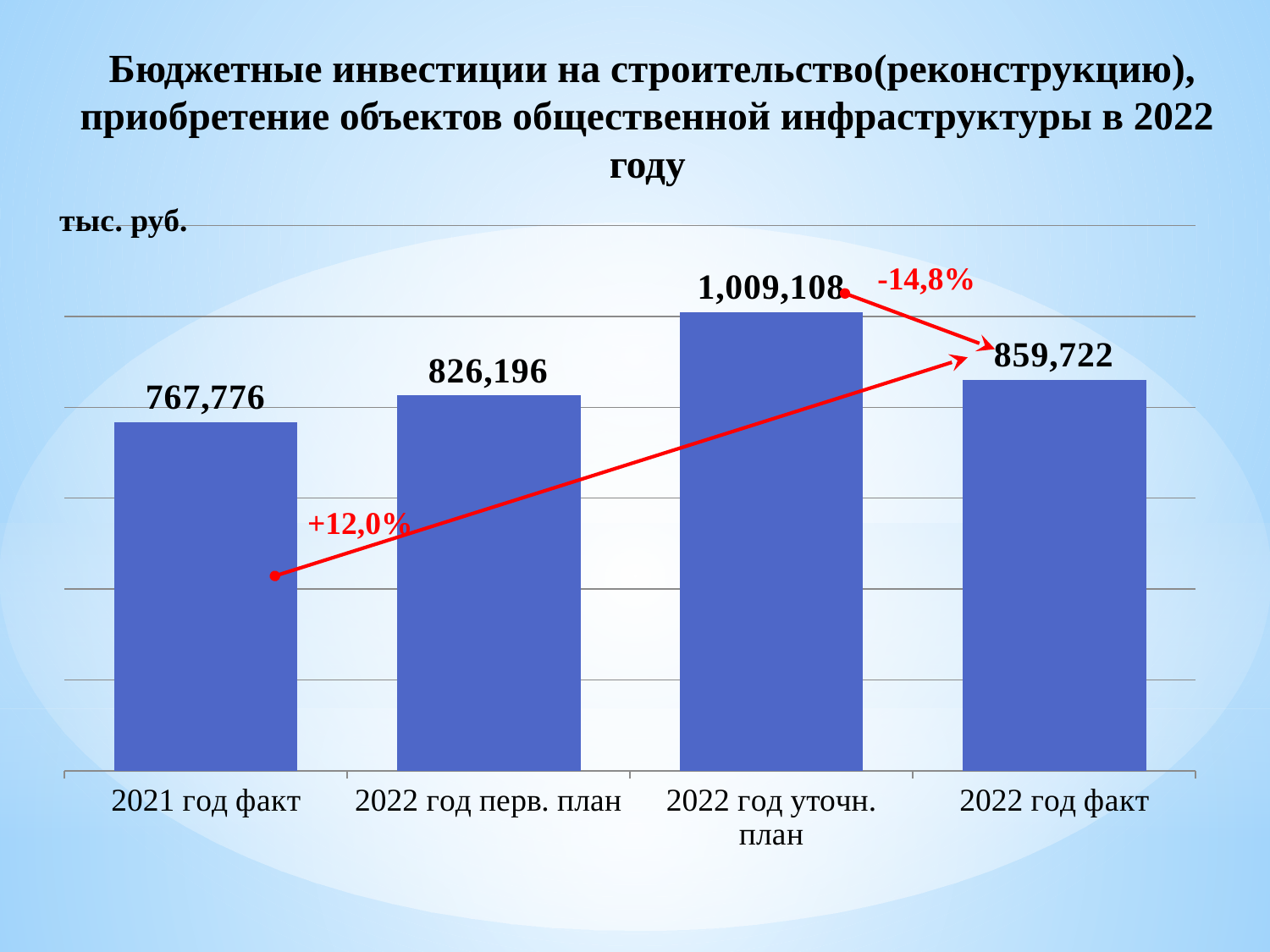
What is the value for 2022 год уточн. план? 1,009,108 What is the difference between the values for 2022 год уточн. план and 2022 год факт? 149,386 What unit of measurement is indicated on the chart? тыс. руб. How many categories are shown on the chart? 4 What kind of chart is shown on the slide? Bar chart What is the difference between the values for 2022 год факт and 2021 год факт? 91,946 Which is larger, the value for 2022 год перв. план or the value for 2022 год факт? 2022 год факт Which category has the highest value? 2022 год уточн. план Which category has the lowest value? 2021 год факт What is the value for 2022 год перв. план? 826,196 What is the value for 2021 год факт? 767,776 What is the value for 2022 год факт? 859,722